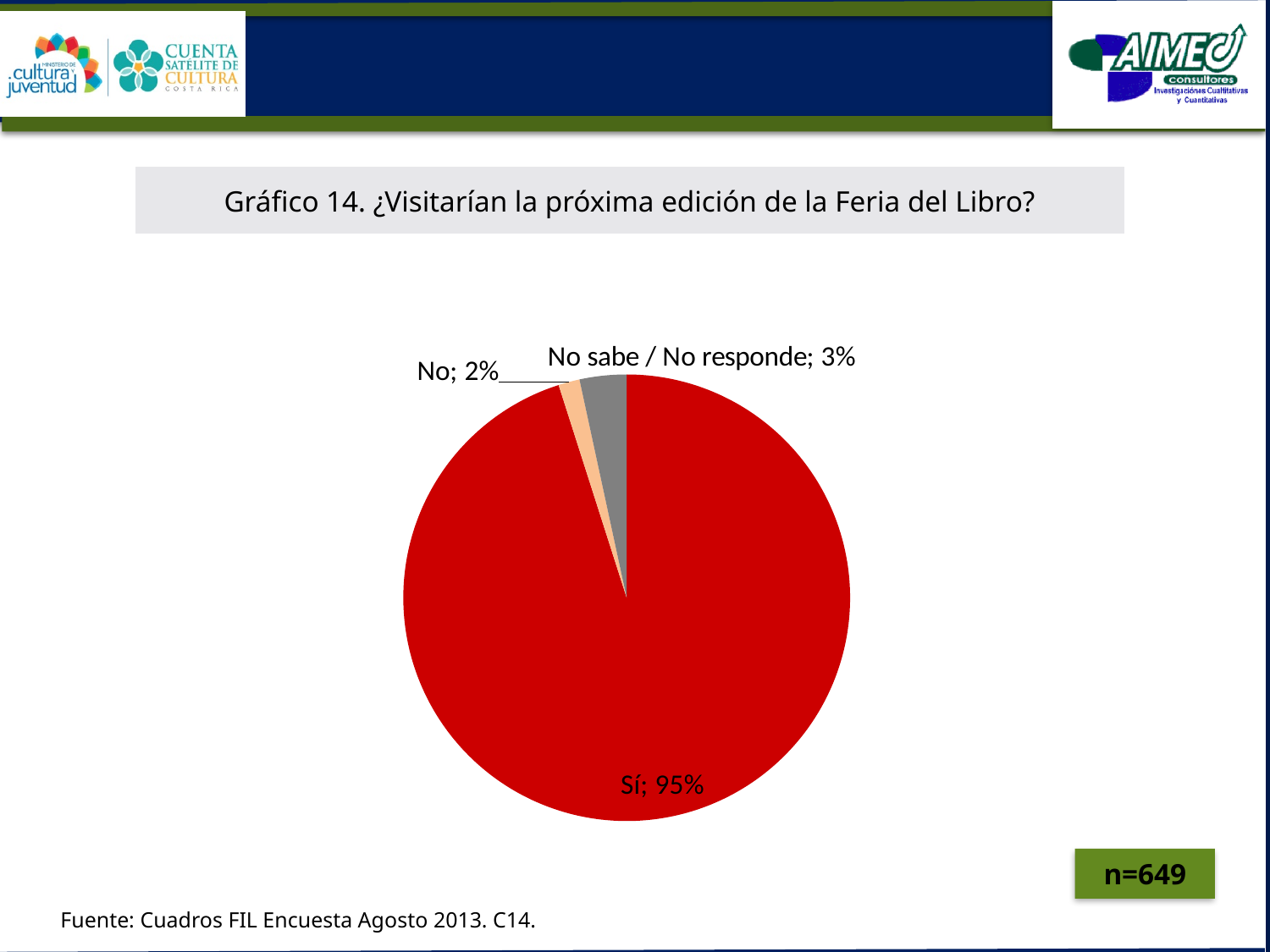
What percentage of respondents answered "No"? 2% What is the title of the chart? Gráfico 14. ¿Visitarían la próxima edición de la Feria del Libro? What percentage of respondents answered "No sabe / No responde"? 3% How many slices does the pie chart have? 3 What is the combined share of "No" and "No sabe / No responde"? 5% What is the difference in percentage points between "Sí" and "No"? 93 Which response has the largest share of the pie? Sí What is the sample size (n) shown on the slide? n=649 Which response has the smallest share of the pie? No What percentage of respondents answered "Sí"? 95% What type of chart is shown on the slide? Pie chart Which is larger, the share for "No" or the share for "No sabe / No responde"? No sabe / No responde